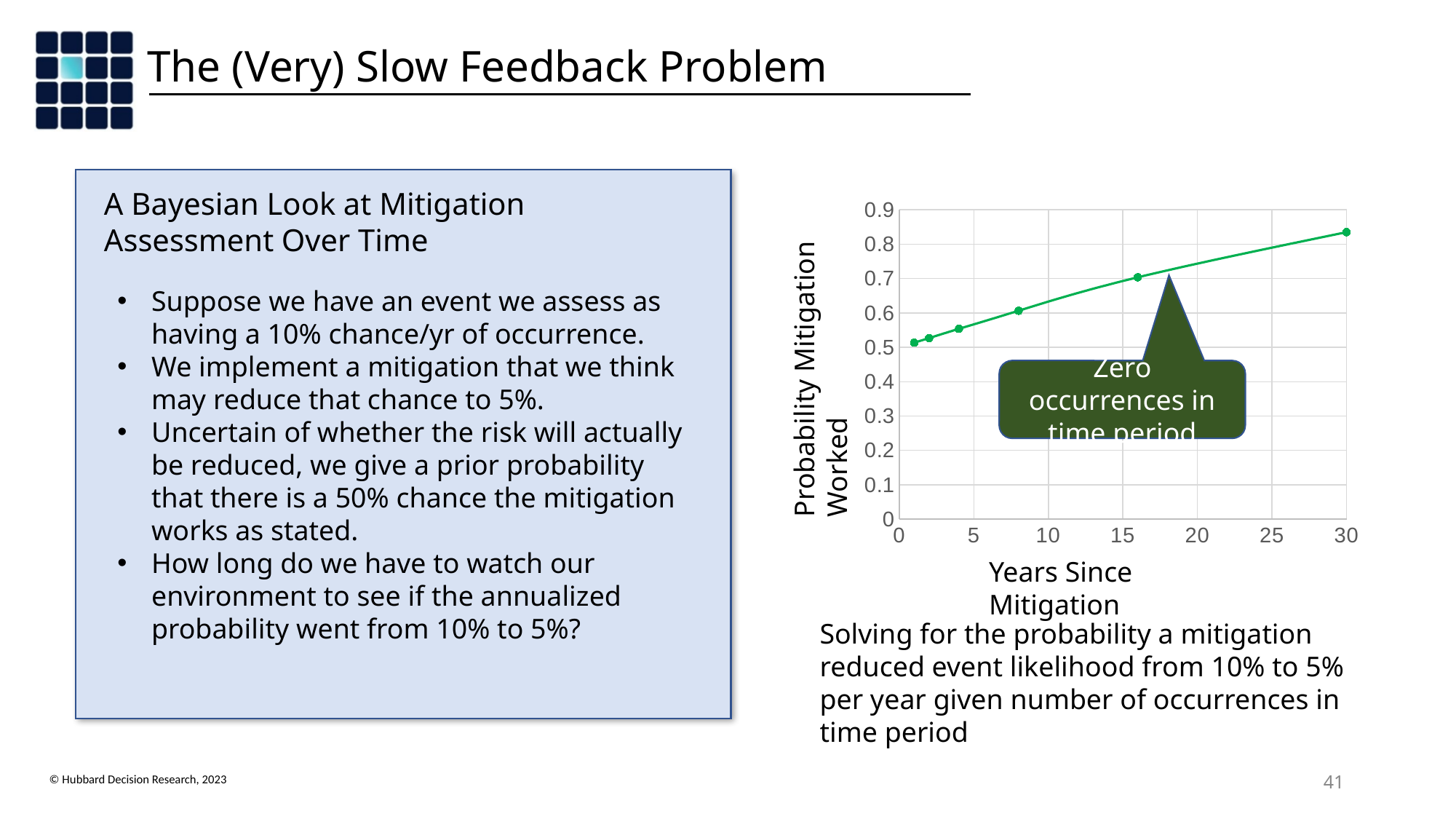
What does the callout on the chart say? Zero occurrences in time period What is the title of the y axis of the chart? Probability Mitigation Worked Is the Probability Mitigation Worked at 8 years greater or less than 0.7? less At which value of Years Since Mitigation is the Probability Mitigation Worked highest? 30 Do the values on the chart rise or fall as Years Since Mitigation increases? rise Is the Probability Mitigation Worked at 16 years greater or less than 0.6? greater What kind of chart is shown on the slide? line chart How many data points are plotted on the line? 6 Which is larger: the Probability Mitigation Worked at 30 years or at 8 years? 30 years Is the Probability Mitigation Worked at 30 years greater or less than 0.8? greater